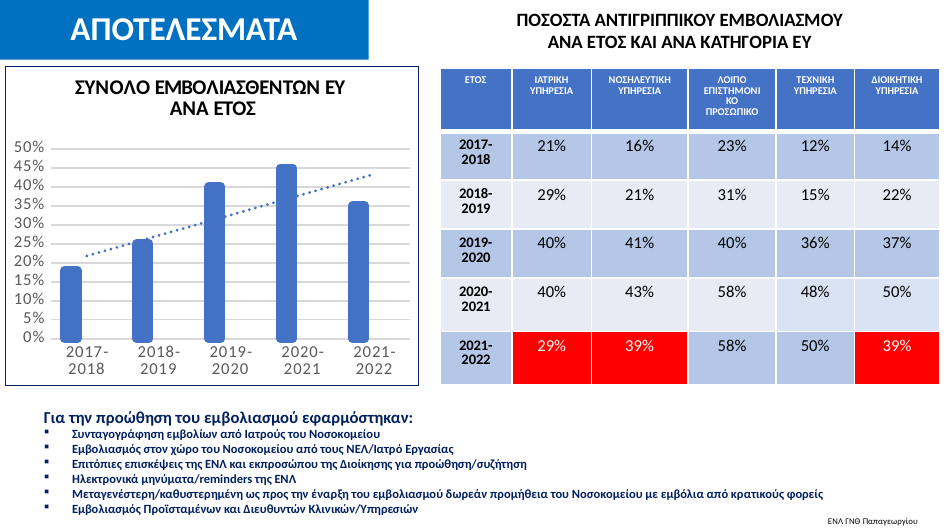
What kind of chart is shown on the slide? bar chart Is the value for 2017-2018 greater or less than 20%? less Do the values rise or fall from 2017-2018 to 2020-2021? rise Is the value for 2020-2021 greater or less than 40%? greater Is the value for 2018-2019 greater or less than 20%? greater How many year categories are plotted in the chart? 5 Which year has the lowest bar in the chart? 2017-2018 Which year has the highest bar in the chart? 2020-2021 Which is larger, the value for 2018-2019 or the value for 2021-2022? 2021-2022 Besides the bars, what other element is drawn across the chart? a dotted trend line What is the title of the chart on the slide? ΣΥΝΟΛΟ ΕΜΒΟΛΙΑΣΘΕΝΤΩΝ ΕΥ ΑΝΑ ΕΤΟΣ